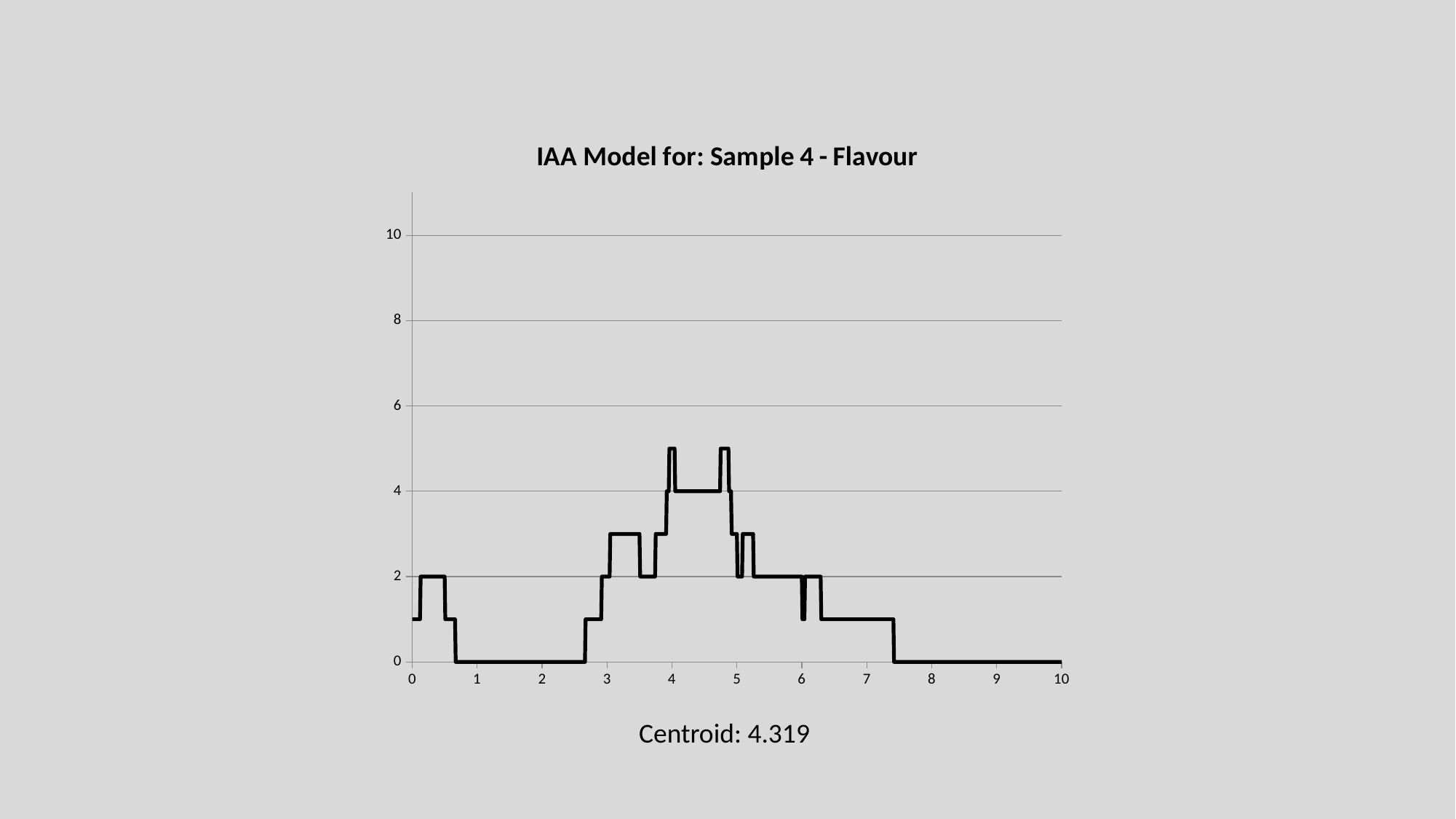
Which is larger, the value of the line at x = 4.5 or at x = 8? x = 4.5 What is the title of the chart? IAA Model for: Sample 4 - Flavour What is the value of the line at x = 1.5? 0 Is the value of the line at x = 7 greater or less than 2? less Does the line rise or fall between x = 3 and x = 4? rise What centroid value is printed below the chart? 4.319 What is the value of the line at x = 8? 0 What is the highest value shown on the y axis? 10 What is the value of the line at x = 5.5? 2 What kind of chart is shown on the slide? line chart What is the value of the line at x = 4.5? 4 Is the peak value of the line greater or less than 4? greater